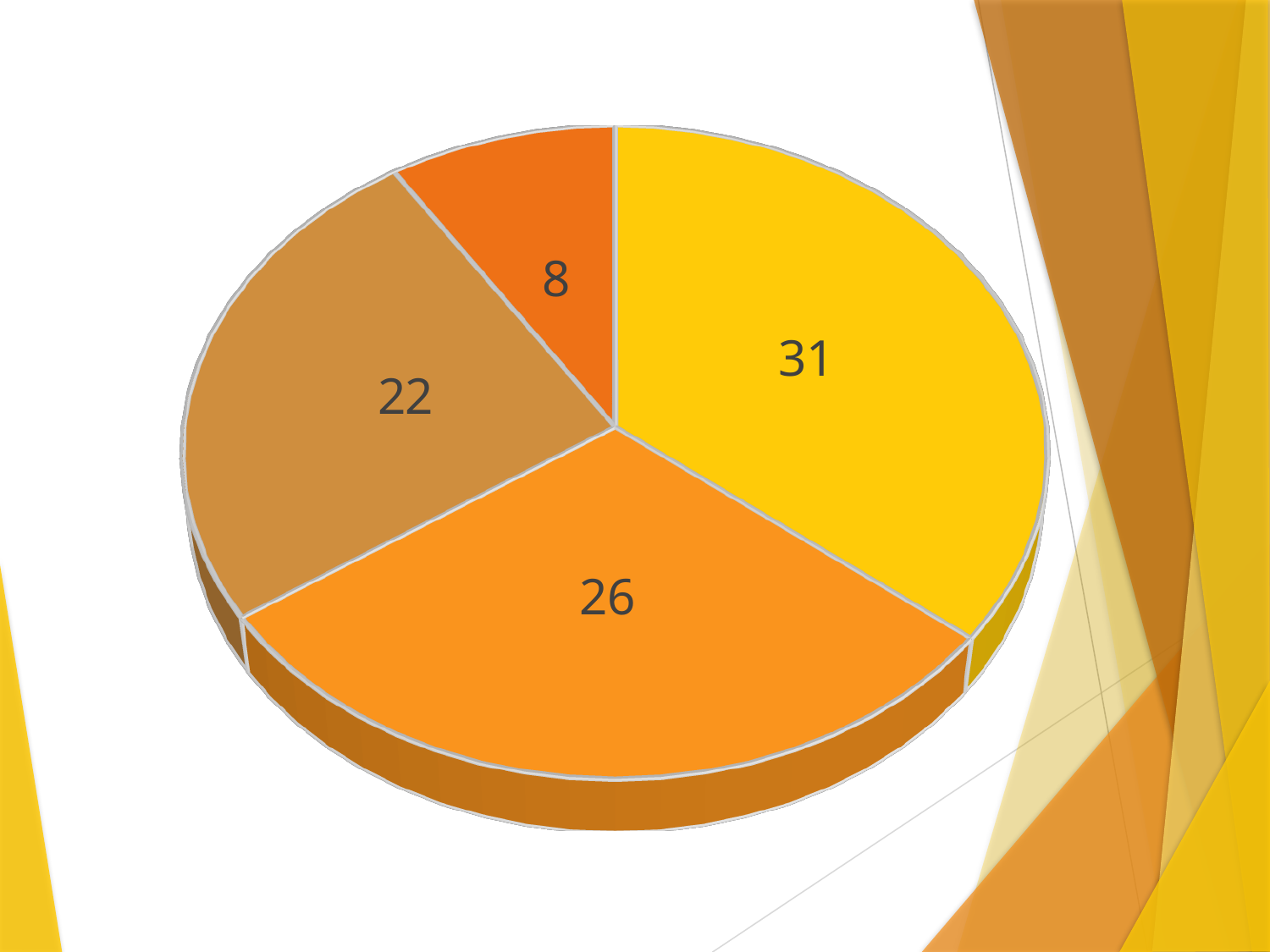
What value is shown on the tan slice on the left of the pie chart? 22 What is the difference between the largest slice (31) and the smallest slice (8)? 23 What value is shown on the orange slice at the bottom of the pie chart? 26 What is the value of the largest slice of the pie chart? 31 What is the value of the smallest slice of the pie chart? 8 What value is shown on the small dark orange slice at the top of the pie chart? 8 What value is shown on the yellow slice on the right of the pie chart? 31 Which is larger, the yellow slice or the tan slice on the left? the yellow slice How many slices does the pie chart have? 4 What is the sum of all four slice values in the pie chart? 87 What is the difference between the slice labelled 26 and the slice labelled 22? 4 What kind of chart is shown on the slide? pie chart